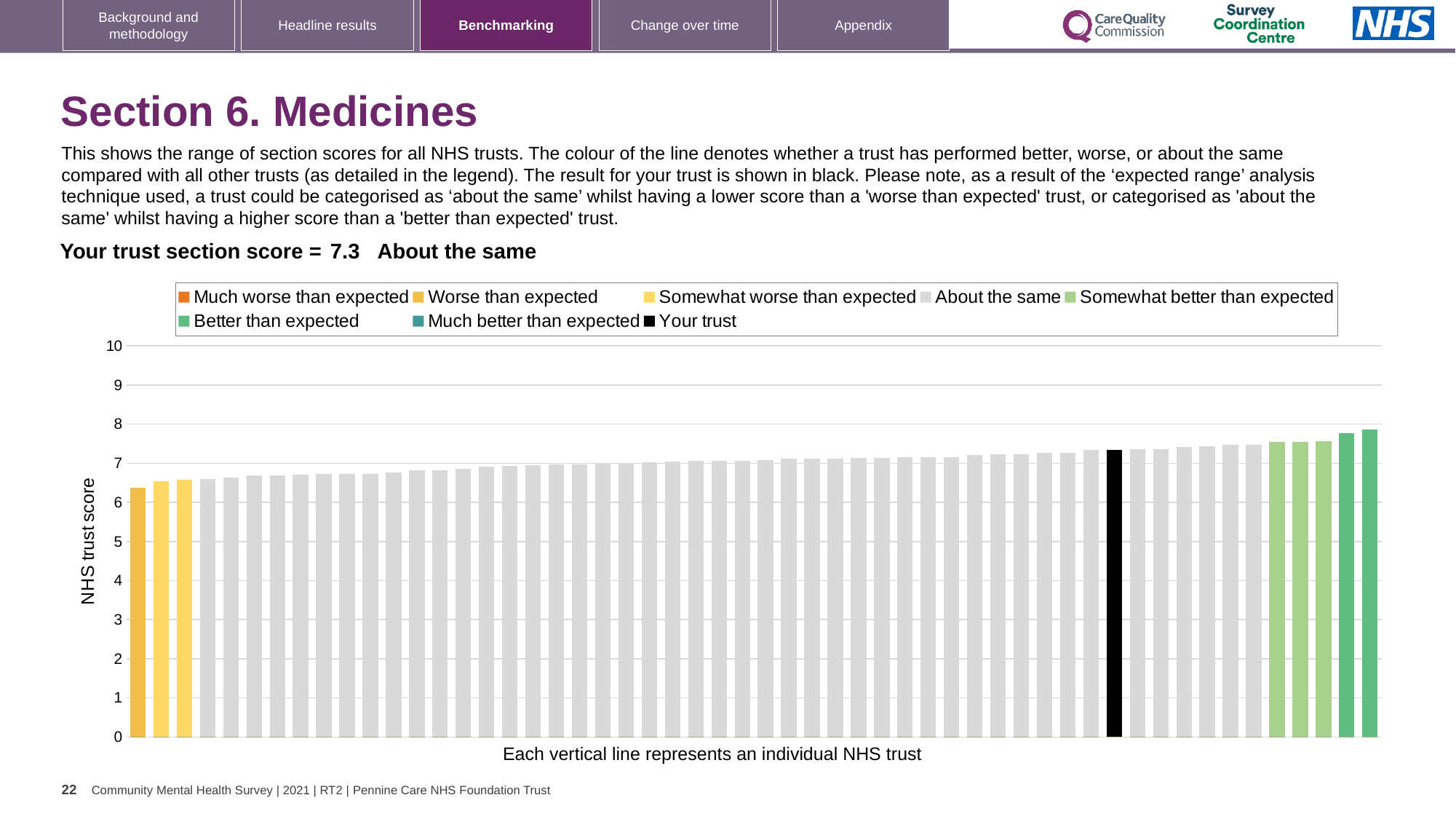
Is the value of the leftmost bar greater or less than 7? less Is the value of the leftmost bar greater or less than 6? greater Do the bar values rise or fall from left to right along the x axis? rise What is the section score for your trust shown on the slide? 7.3 What colour is used for the bar representing your trust? black Is the value of the black bar (your trust) greater or less than 7? greater What is the label on the vertical axis of the chart? NHS trust score What kind of chart is shown on the slide? bar chart How many entries does the chart legend list? 8 How many bars are coloured yellow (worse or somewhat worse than expected)? 3 Which category is your trust placed in for this section? About the same